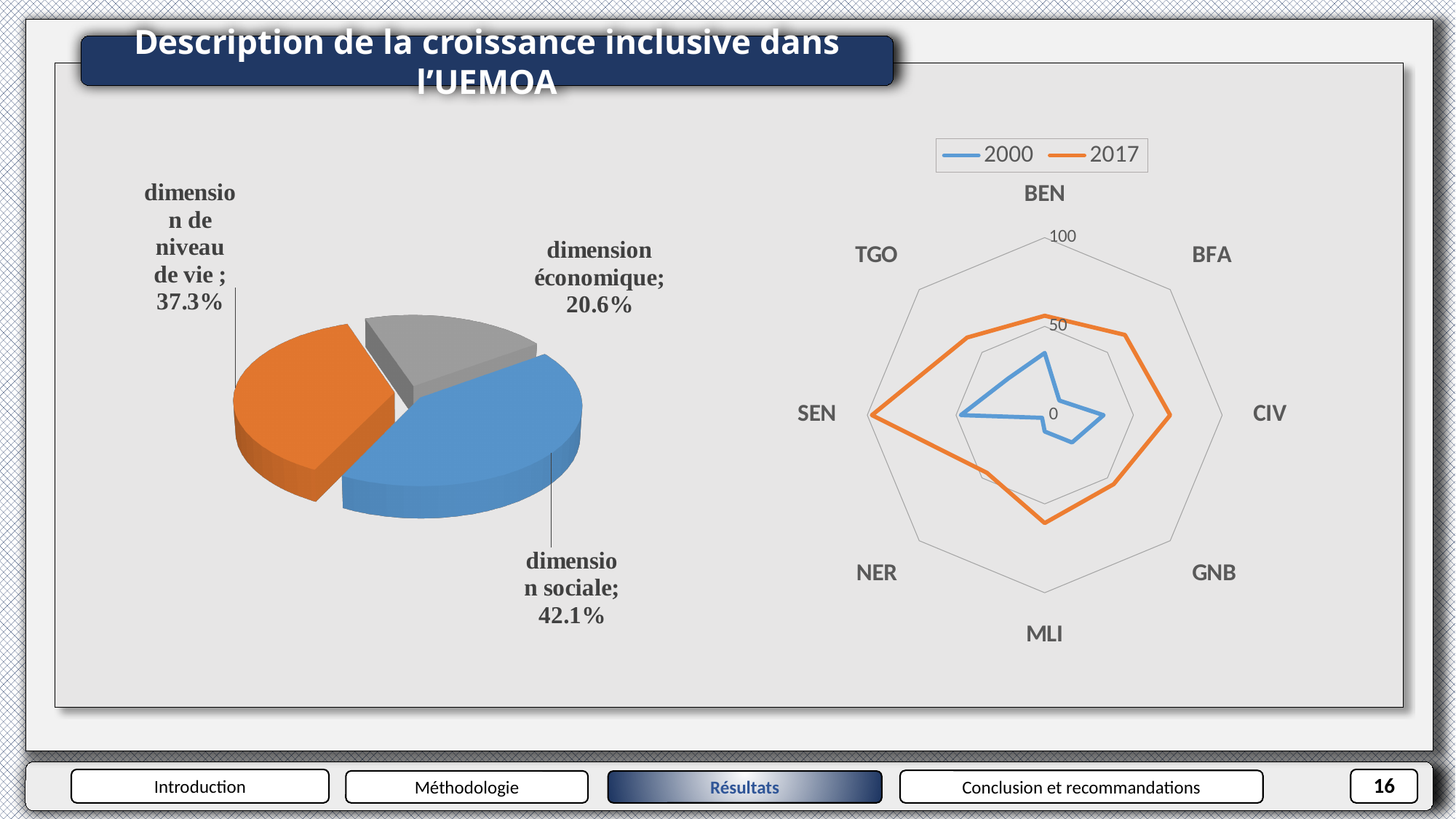
In the radar chart on the right, how many countries are plotted? 8 In the radar chart on the right, is the 2000 value for NER greater or less than 50? less In the pie chart on the left, how many slices are there? 3 In the pie chart on the left, which dimension has the smallest share? dimension économique In the radar chart on the right, how many series does the legend list? 2 In the pie chart on the left, what is the difference between 'dimension sociale' and 'dimension économique'? 21.5% In the pie chart on the left, which dimension has the largest share? dimension sociale In the pie chart on the left, what is the value for 'dimension de niveau de vie'? 37.3% In the radar chart on the right, is the 2017 value for SEN greater or less than 50? greater In the pie chart on the left, what is the value for 'dimension sociale'? 42.1% What kind of chart is the chart on the left? pie chart In the pie chart on the left, what is the value for 'dimension économique'? 20.6%